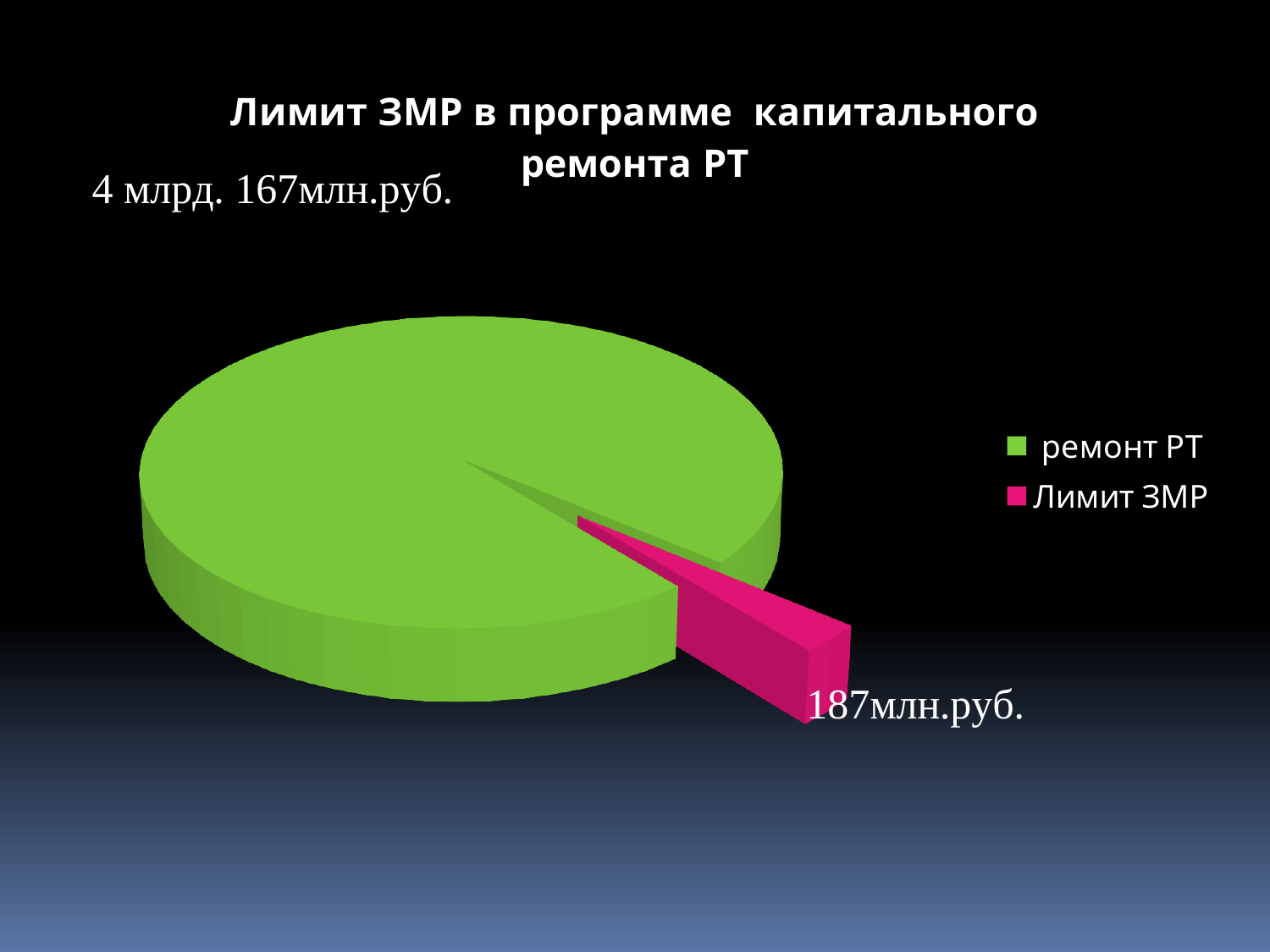
What kind of chart is shown on the slide? pie chart What value is printed next to the Лимит ЗМР slice? 187млн.руб. What colour is the Лимит ЗМР slice? pink What is the title of the chart? Лимит ЗМР в программе капитального ремонта РТ How many slices does the pie chart have? 2 Which slice of the pie is the smallest? Лимит ЗМР How many series does the legend list? 2 Which slice of the pie is the largest? ремонт РТ Which legend entry is shown in green? ремонт РТ Which is larger, the ремонт РТ slice or the Лимит ЗМР slice? ремонт РТ What value is printed for ремонт РТ on the slide? 4 млрд. 167млн.руб.